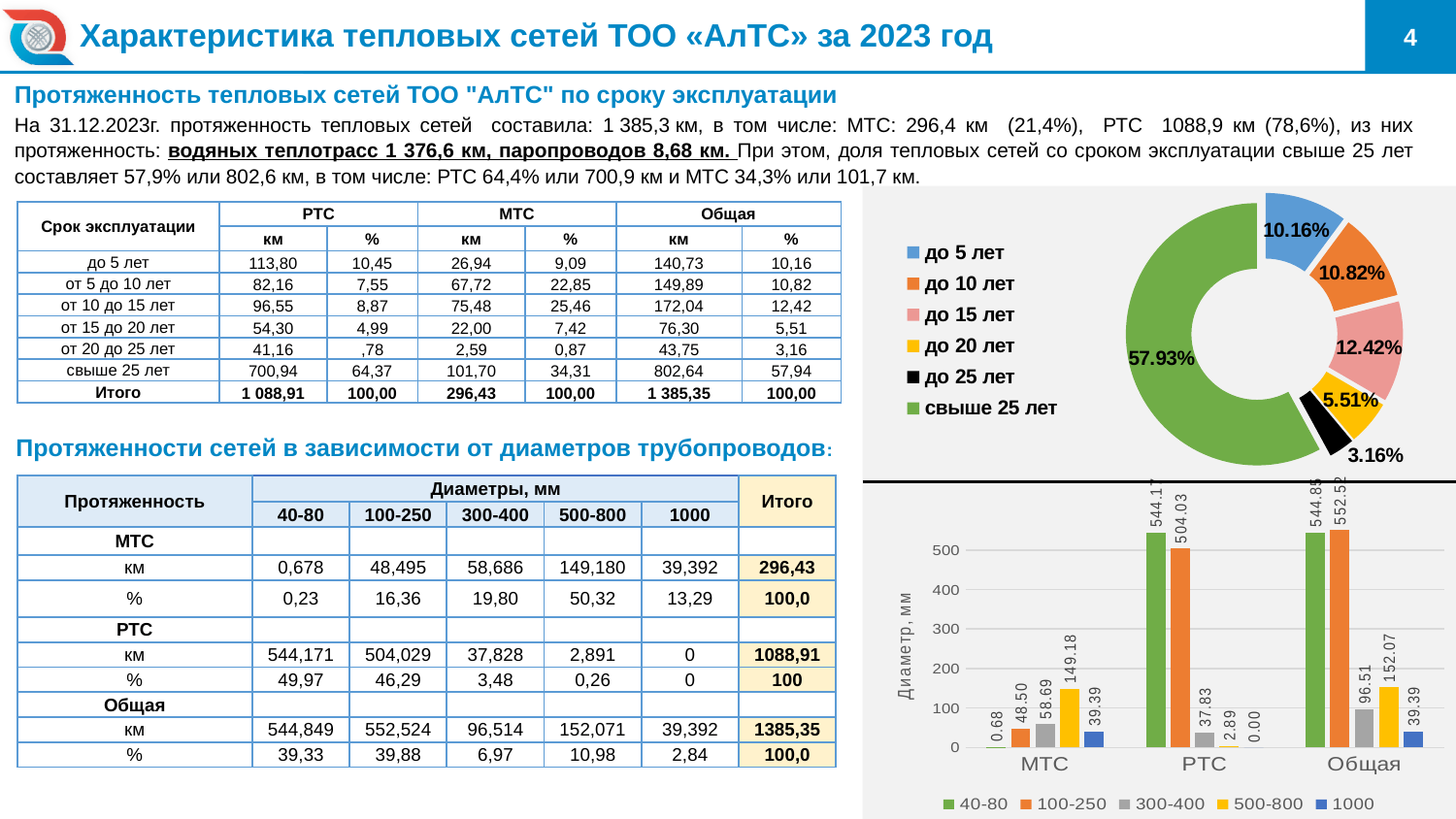
In the bottom-right bar chart, what is the value for the 40-80 series in the РТС group? 544.17 What kind of chart is the bottom-right chart? bar chart In the pie chart on the right, what is the difference between the 'до 15 лет' share and the 'до 20 лет' share? 6.91% In the bottom-right bar chart, what is the difference between the 100-250 value and the 300-400 value in the Общая group? 456.01 In the bottom-right bar chart, how many series does the legend list? 5 In the bottom-right bar chart, which series has the highest value in the Общая group? 100-250 In the pie chart on the right, which category has the smallest share? до 25 лет In the pie chart on the right, what percentage is shown for the 'до 5 лет' slice? 10.16% In the bottom-right bar chart, what is the value for the 500-800 series in the МТС group? 149.18 In the bottom-right bar chart, which is larger in the МТС group: the 300-400 value or the 1000 value? 300-400 In the pie chart on the right, how many categories does the legend list? 6 In the pie chart on the right, what share of the heat networks is in the 'свыше 25 лет' category? 57.93%